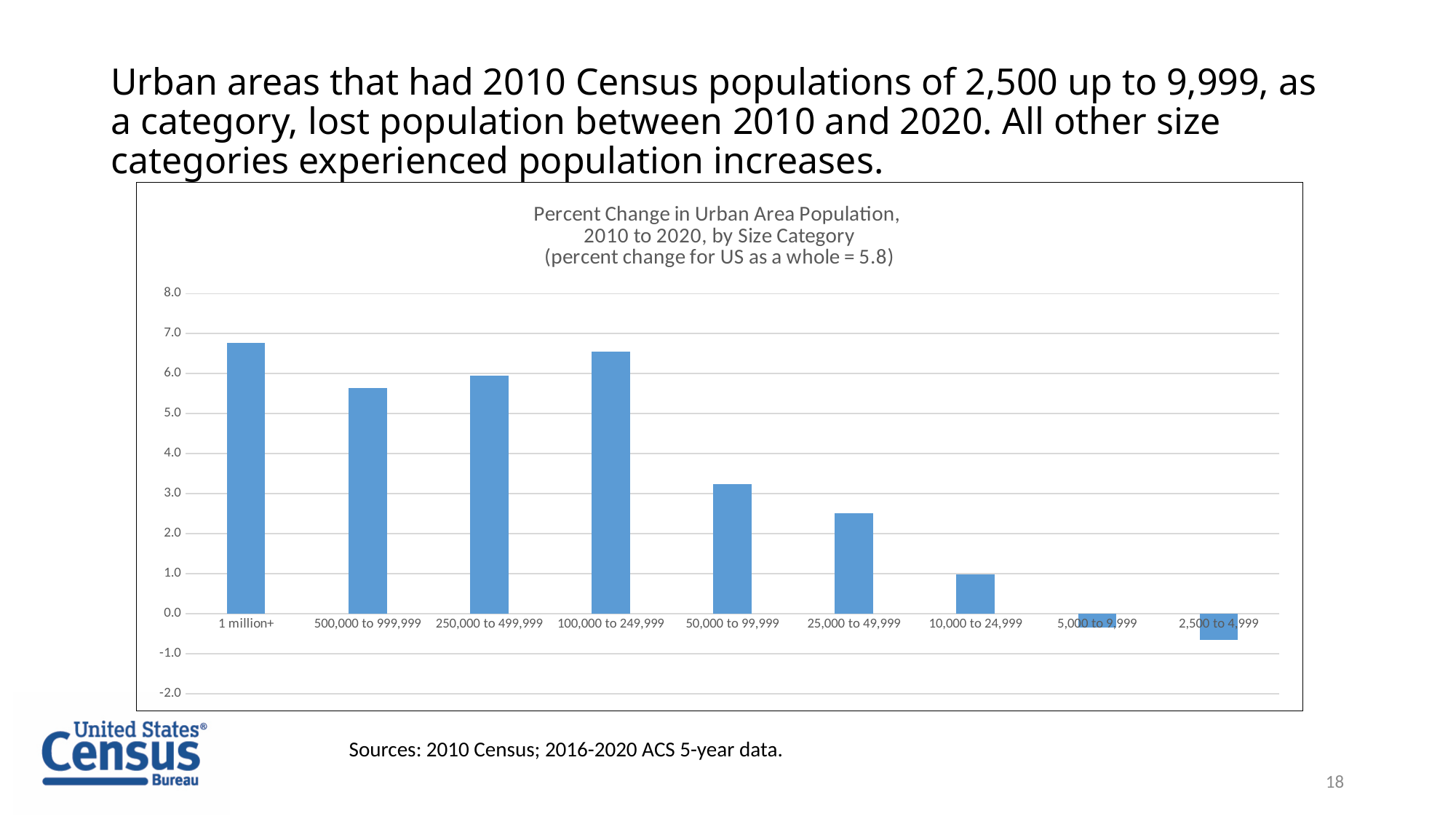
Is the value for 10,000 to 24,999 greater or less than 2.0? less Which size category has the highest percent change in urban area population? 1 million+ Is the value for 25,000 to 49,999 greater or less than 3.0? less Is the value for 1 million+ greater or less than 6.0? greater Do the values generally rise or fall moving from left to right along the x axis? fall Which has the larger percent change: 50,000 to 99,999 or 25,000 to 49,999? 50,000 to 99,999 According to the chart title, what is the percent change for the US as a whole? 5.8 Which size category has the lowest percent change in urban area population? 2,500 to 4,999 What kind of chart is shown on the slide? bar chart How many size categories are plotted on the x axis? 9